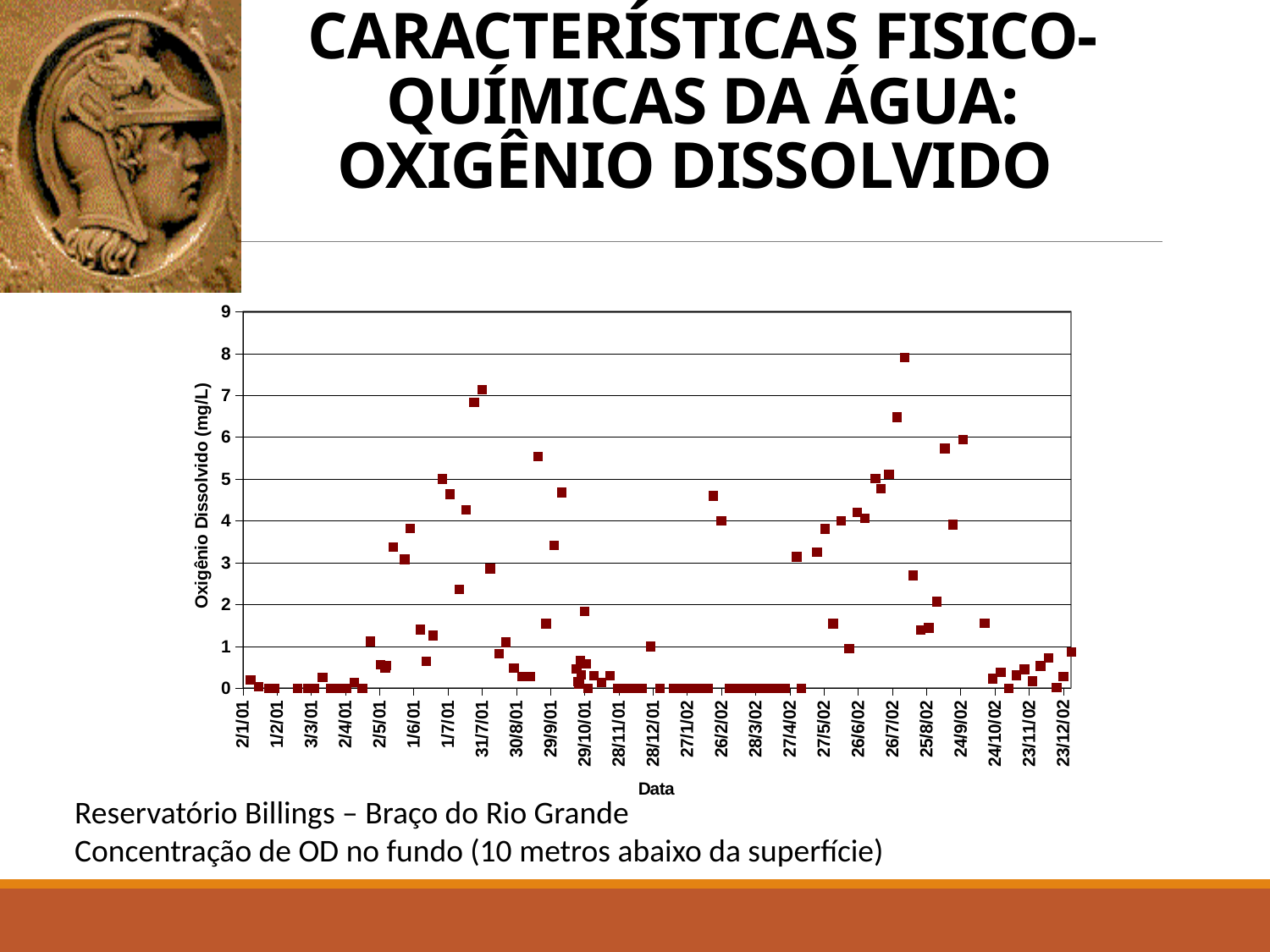
Are the values plotted around 28/3/02 greater or less than 1? less What is the label of the horizontal axis of the chart? Data Is the highest plotted dissolved oxygen value greater or less than 7? greater What kind of chart is shown on the slide? scatter chart Between 2/5/01 and 1/7/01, do the plotted values generally rise or fall? rise Are the values plotted around 1/2/01 greater or less than 1? less What is the first date label shown on the horizontal axis? 2/1/01 What is the highest tick value shown on the vertical axis? 9 How many date labels are shown on the horizontal axis? 25 What is the last date label shown on the horizontal axis? 23/12/02 What is the label of the vertical axis of the chart? Oxigênio Dissolvido (mg/L)